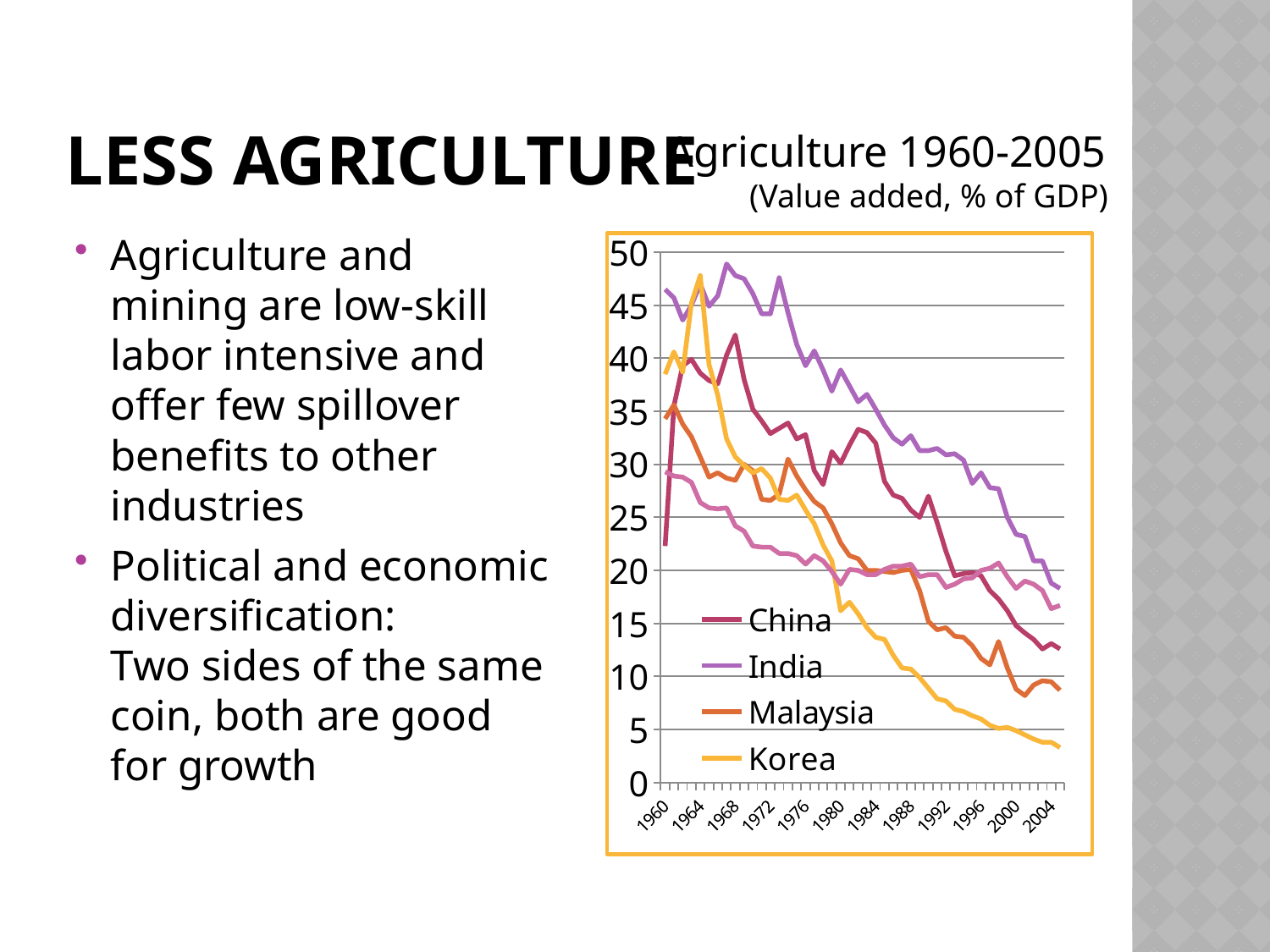
Which countries are listed in the chart's legend? China, India, Malaysia, Korea What kind of chart is shown on the slide? Line chart How many series does the chart's legend list? 4 Does the value for Korea generally rise or fall from 1968 to 2004? Fall Is the value for Malaysia in 2000 greater or less than 10? less In 1960, which is larger: the value for Malaysia or the value for China? Malaysia Is the value for China in 1960 greater or less than 25? less What is the title of the chart? Agriculture 1960-2005 (Value added, % of GDP) Which series has the lowest value in 2004? Korea Which series has the highest value in 2004? India Is the value for Korea in 2004 greater or less than 5? less